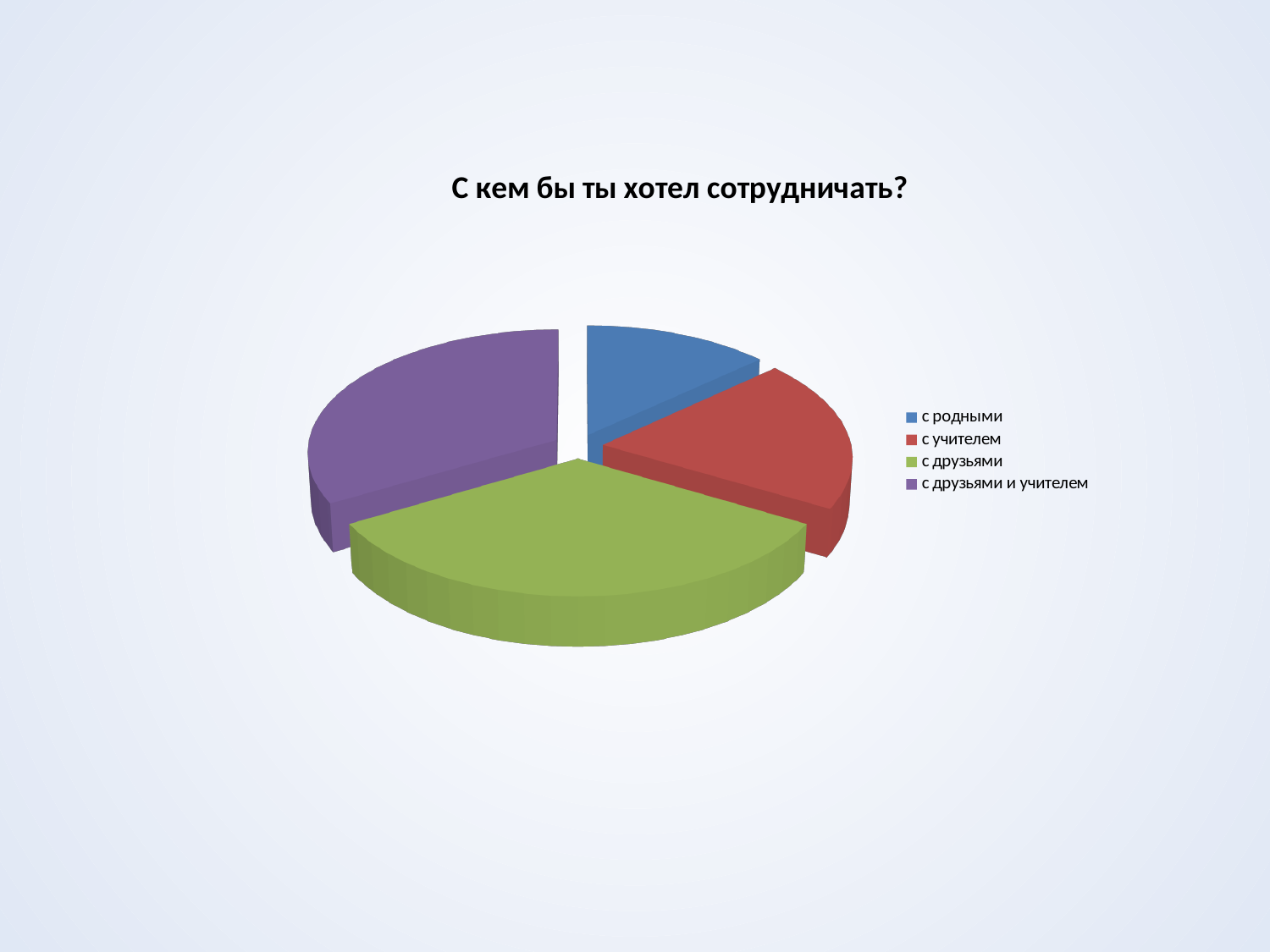
Which slice is larger: 'с учителем' or 'с родными'? с учителем How many categories (slices) does the pie chart have? 4 What is the title of the chart? С кем бы ты хотел сотрудничать? Which slice is larger: 'с друзьями' or 'с родными'? с друзьями How many entries does the legend list? 4 Which slice is larger: 'с друзьями и учителем' or 'с учителем'? с друзьями и учителем What kind of chart is shown on the slide? Pie chart Which category has the smallest slice of the pie? с родными Which colour represents 'с друзьями и учителем' in the chart? Purple